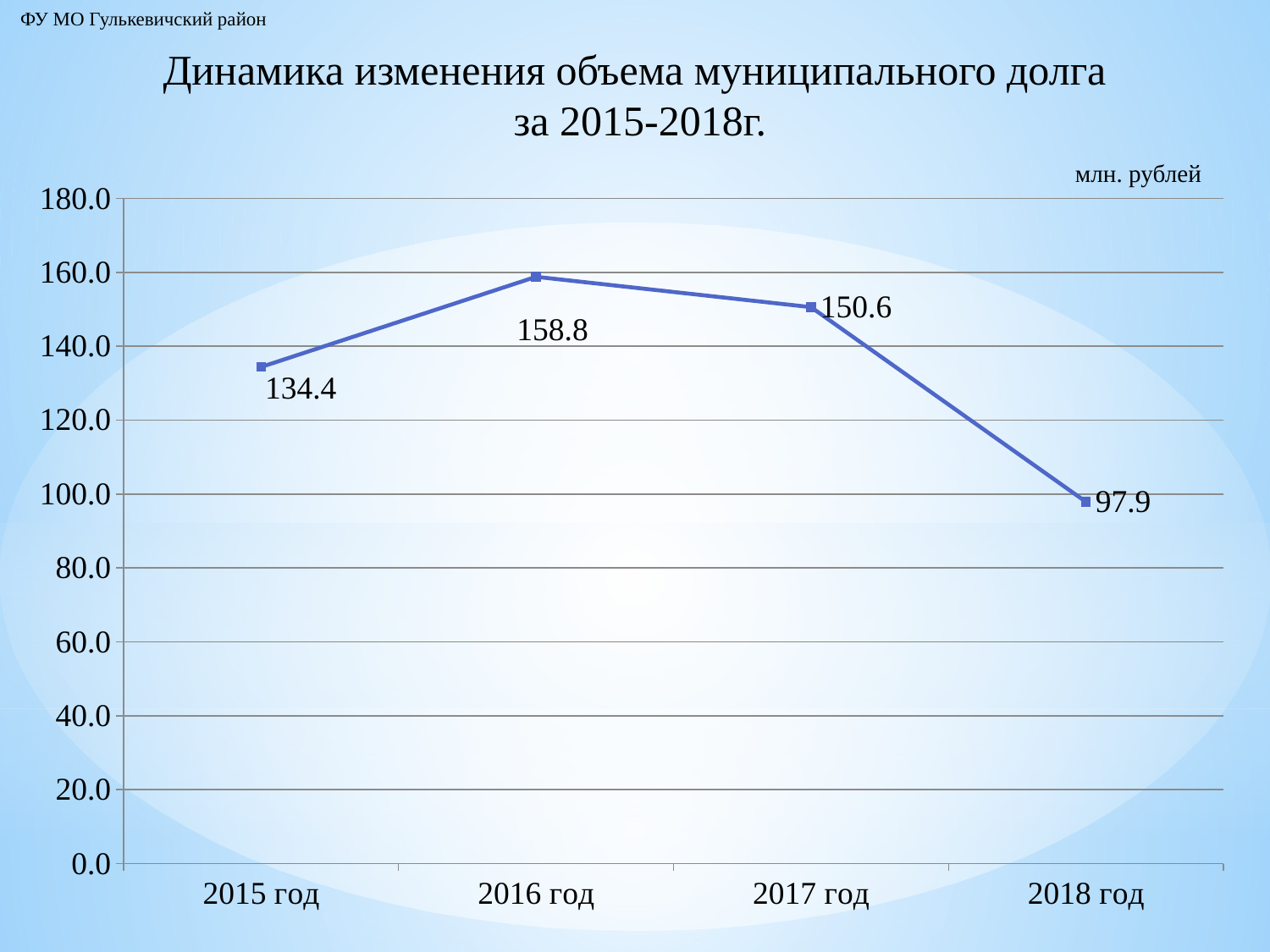
How many years are plotted on the chart? 4 What is the value for 2016 год? 158.8 What unit is indicated above the chart? млн. рублей Which is larger, the value for 2015 год or the value for 2017 год? 2017 год Which year has the lowest value? 2018 год What is the difference between the values for 2016 год and 2015 год? 24.4 What kind of chart is shown on the slide? line chart Which year has the highest value? 2016 год What is the value for 2015 год? 134.4 What is the value for 2018 год? 97.9 What is the difference between the values for 2017 год and 2018 год? 52.7 Is the value for 2018 год greater or less than 100.0? less